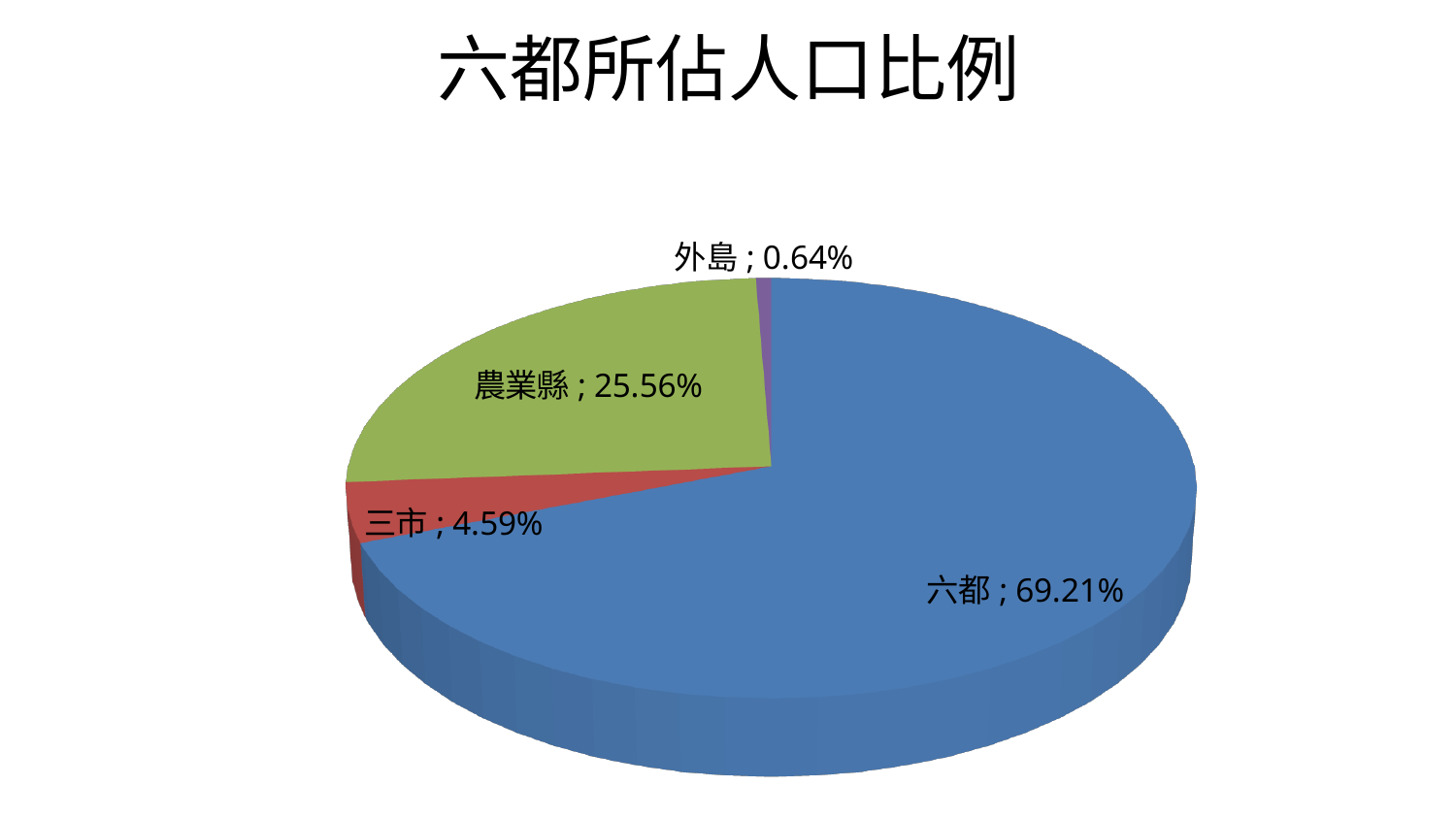
Which is larger, the share for 農業縣 or the share for 三市? 農業縣 What share of the pie does 六都 represent? 69.21% What type of chart is shown on the slide? Pie chart What colour is the slice for 農業縣? Green Which category has the smallest share of the pie? 外島 What is the title of the chart? 六都所佔人口比例 What share of the pie does 農業縣 represent? 25.56% What share of the pie does 外島 represent? 0.64% What share of the pie does 三市 represent? 4.59% How many slices does the pie chart have? 4 Which category has the largest share of the pie? 六都 What is the difference in percentage points between the shares of 六都 and 農業縣? 43.65